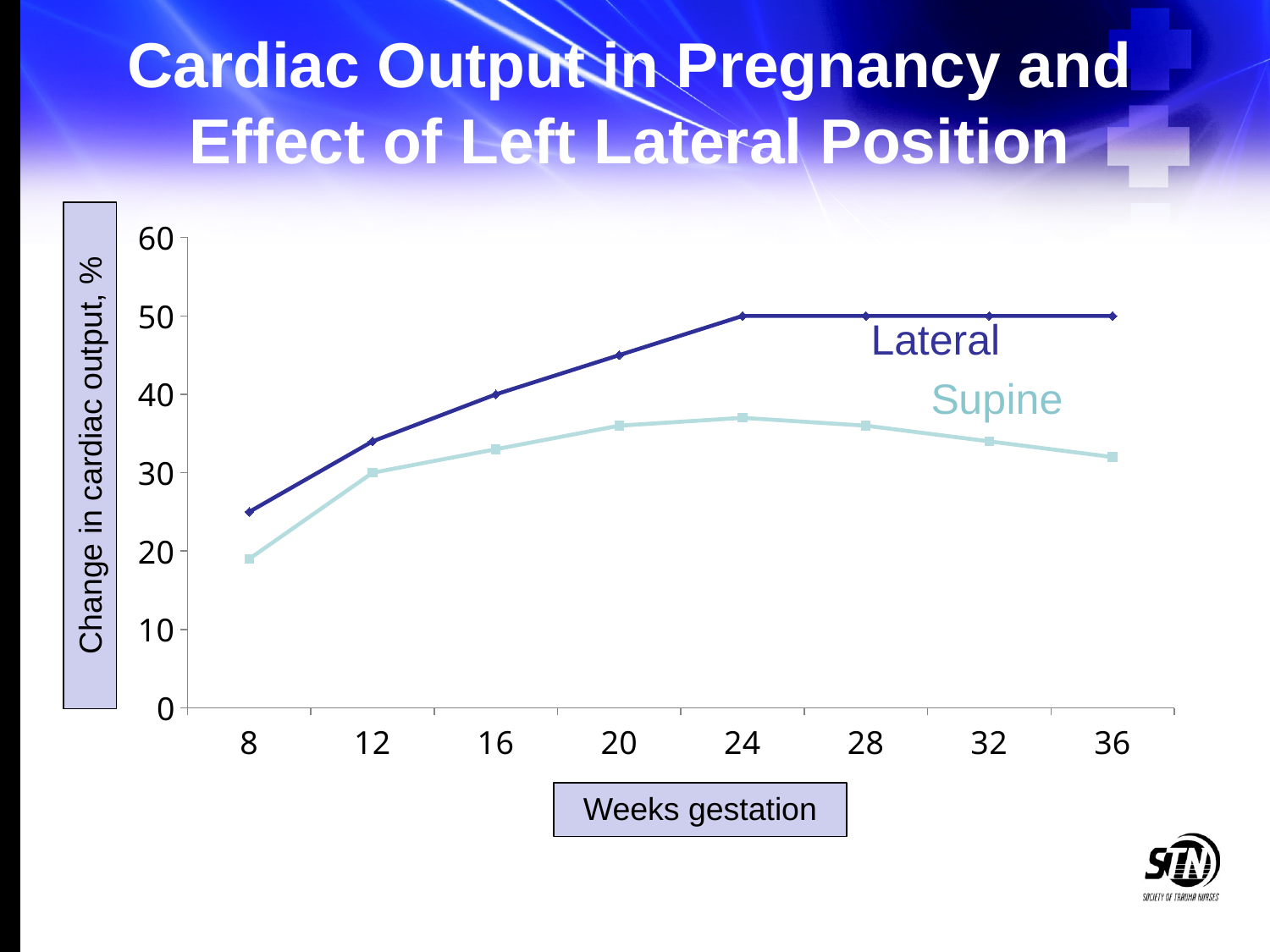
What is the label on the y axis of the chart? Change in cardiac output, % At 36 weeks gestation, which series has the larger change in cardiac output, Lateral or Supine? Lateral How many data series are plotted on the chart? 2 What is the change in cardiac output for the Lateral series at 24 weeks gestation? 50 Does the Supine line rise or fall between 24 and 36 weeks gestation? fall What is the difference between the Lateral values at 24 weeks and 16 weeks gestation? 10 Is the value for the Lateral series at 20 weeks gestation greater or less than 40? greater What is the change in cardiac output for the Supine series at 12 weeks gestation? 30 How many weeks-gestation points are marked along the x axis? 8 What is the change in cardiac output for the Lateral series at 16 weeks gestation? 40 What kind of chart is shown on the slide? line chart